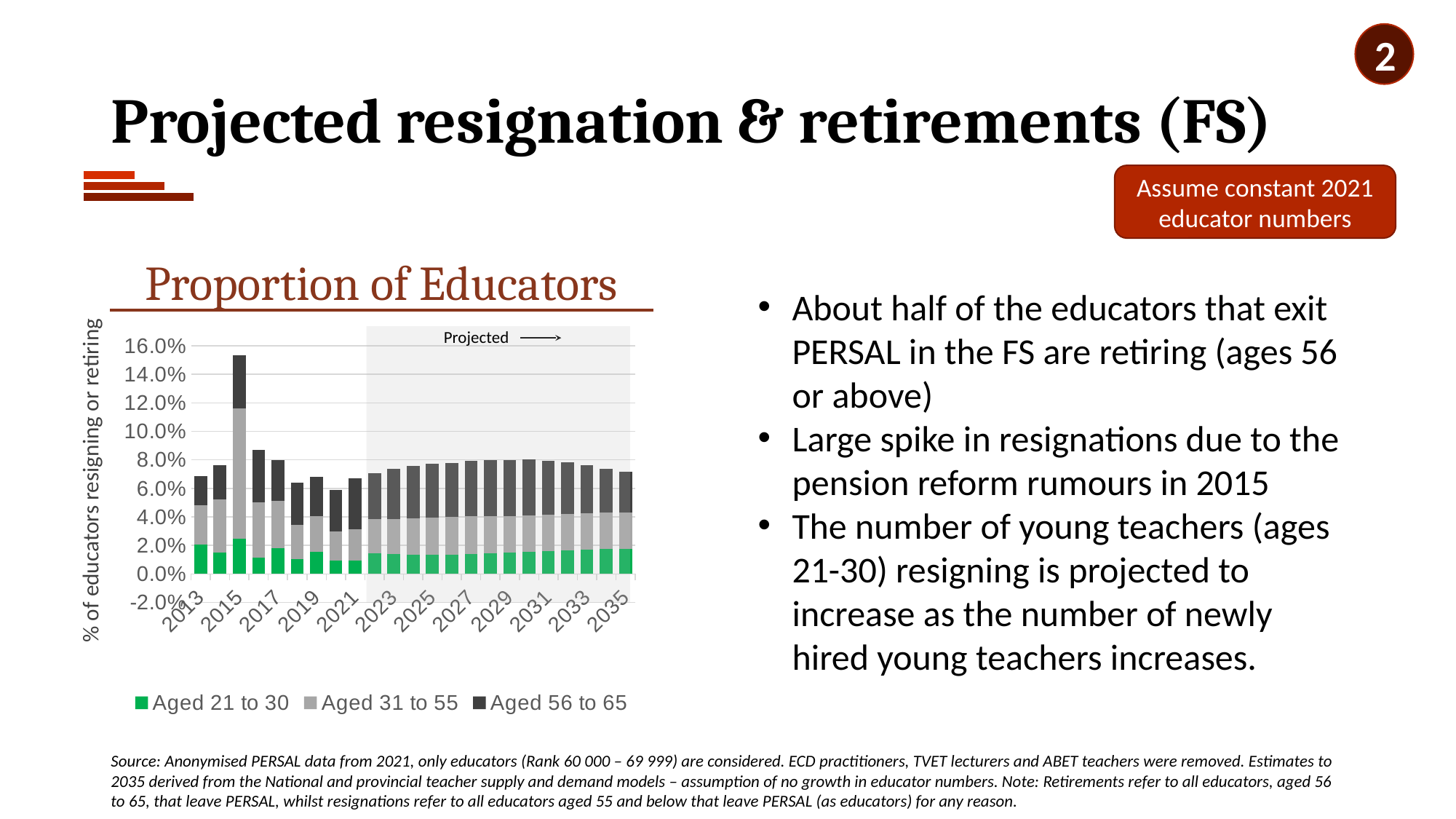
Is the total value for 2020 greater or less than 8.0%? less What is the title of the chart? Proportion of Educators Which year has a larger total bar, 2015 or 2016? 2015 Is the total value for 2015 greater or less than 14.0%? greater Is the total value for 2035 greater or less than 8.0%? less How many years (bars) are plotted in the chart? 23 Which year has a larger total bar, 2020 or 2015? 2015 Which year has the highest total proportion of educators resigning or retiring? 2015 What kind of chart is shown on the slide? Stacked bar chart Which age groups are listed in the chart's legend? Aged 21 to 30, Aged 31 to 55, Aged 56 to 65 How many series does the chart's legend list? 3